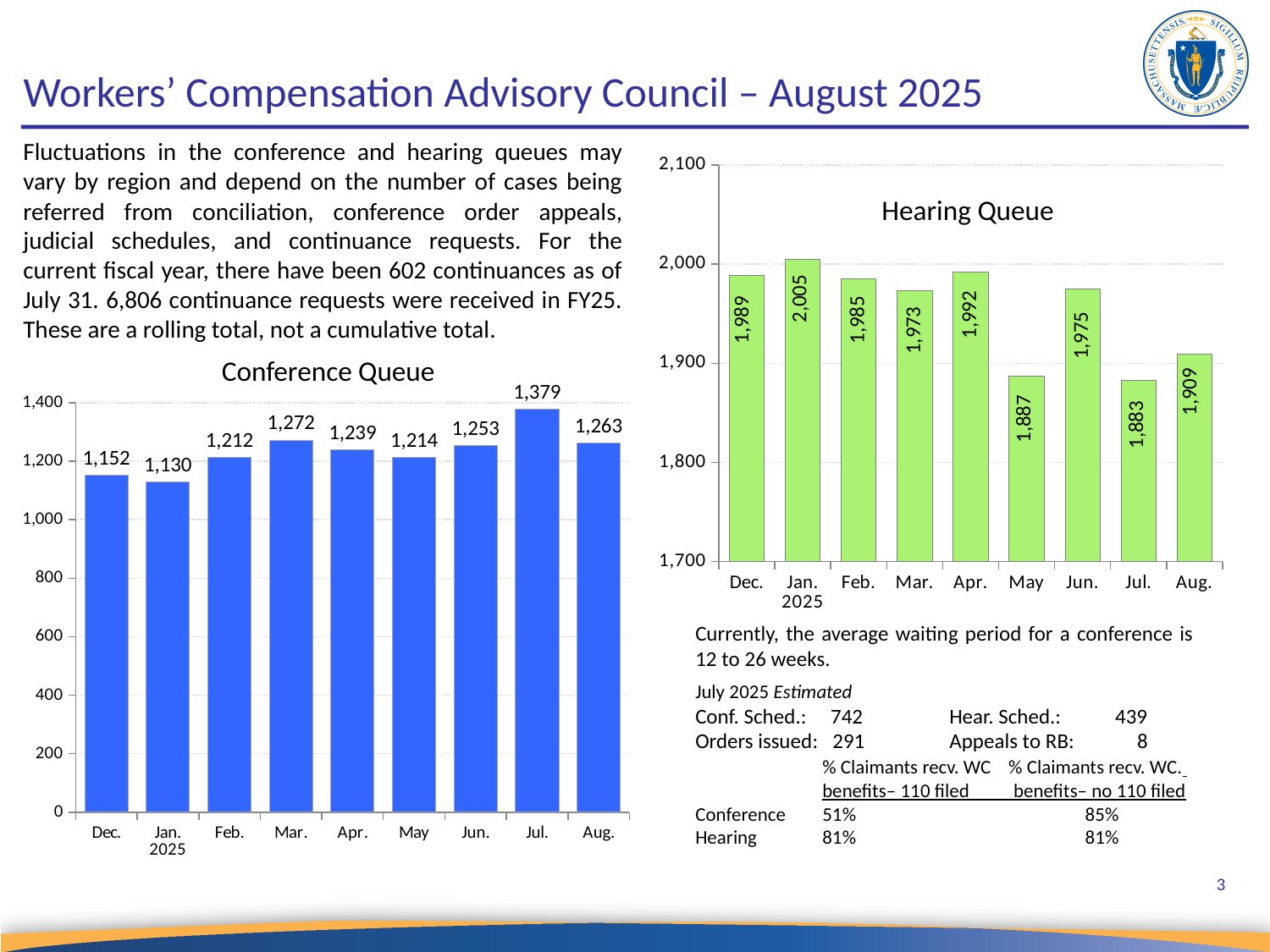
How many months are plotted in the Conference Queue chart? 9 In the Hearing Queue chart, what is the difference between the Apr. and May values? 105 In the Conference Queue chart, what is the difference between the Jul. and Aug. values? 116 In the Hearing Queue chart, which month has the highest value? Jan. 2025 In the Conference Queue chart, what is the value for Jul.? 1,379 In the Hearing Queue chart, what is the value for Jan. 2025? 2,005 In the Hearing Queue chart, which month has the lowest value? Jul. What colour are the bars in the Conference Queue chart? Blue In the Conference Queue chart, which is larger, the value for Mar. or the value for Jun.? Mar. What kind of chart is the Hearing Queue chart? Bar chart In the Conference Queue chart, which month has the lowest value? Jan. 2025 In the Hearing Queue chart, is the value for Aug. greater or less than 1,900? greater